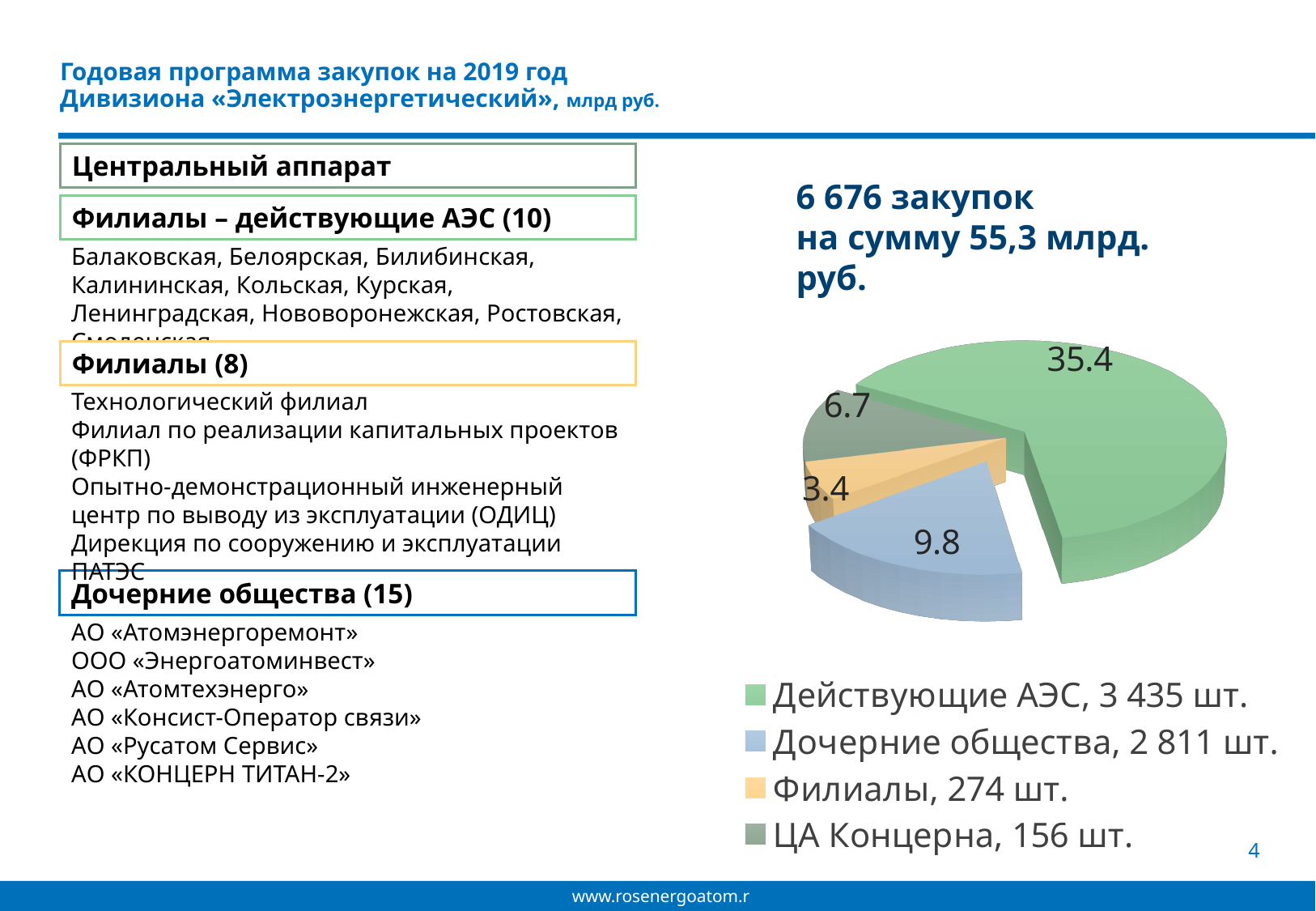
What value is shown for the ЦА Концерна slice of the pie chart? 6.7 What is the difference between the Действующие АЭС value and the Дочерние общества value in the pie chart? 25.6 Which is larger in the pie chart: ЦА Концерна or Филиалы? ЦА Концерна What type of chart is shown on the slide? Pie chart How many slices does the pie chart have? 4 Which category has the smallest slice in the pie chart? Филиалы Which category has the largest slice in the pie chart? Действующие АЭС What colour is the Филиалы slice in the pie chart? Yellow What value is shown for the Филиалы slice of the pie chart? 3.4 According to the legend, how many purchases (шт.) are attributed to Дочерние общества? 2 811 шт. What value is shown for the Дочерние общества slice of the pie chart? 9.8 What value is shown for the Действующие АЭС slice of the pie chart? 35.4